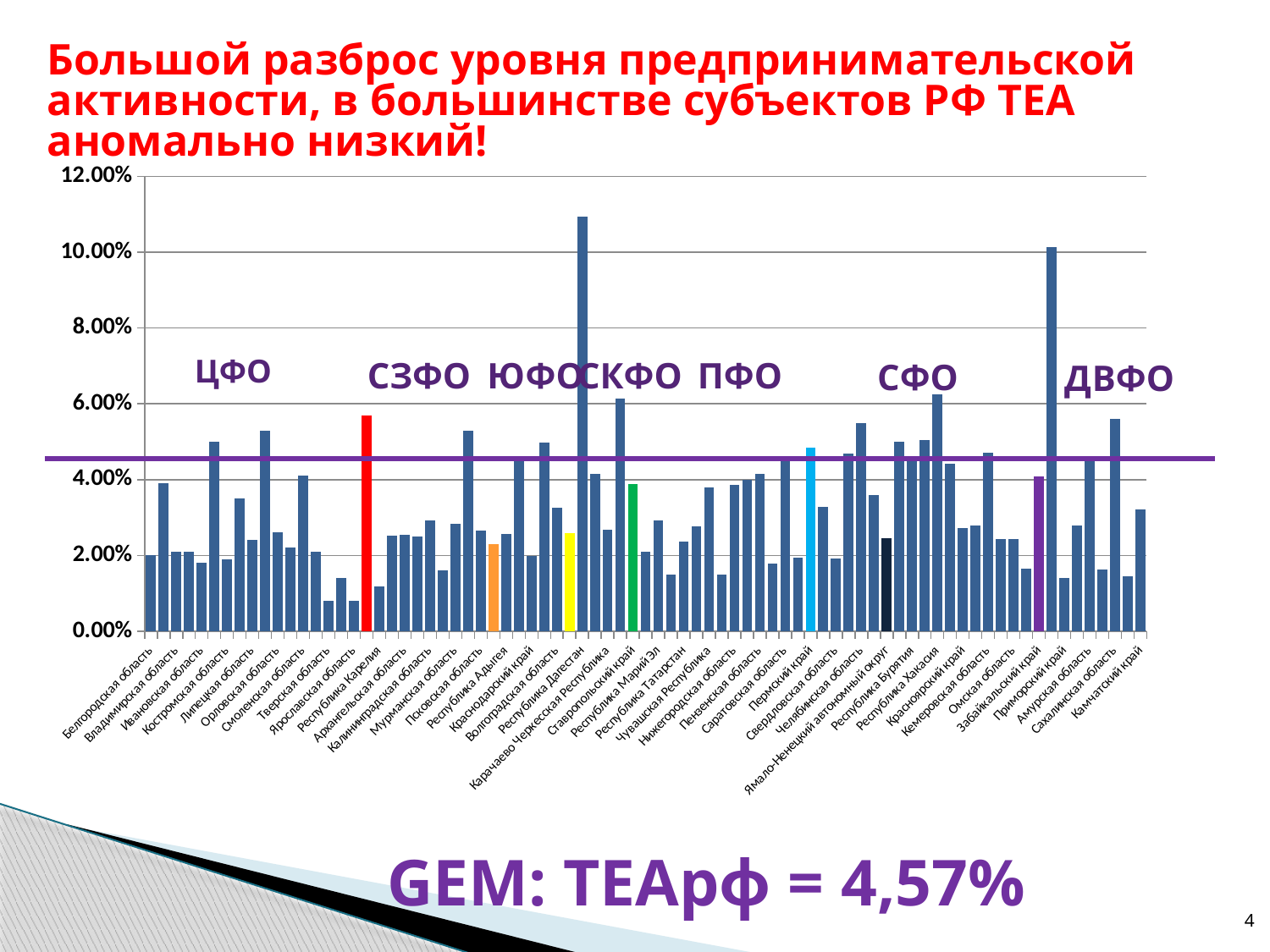
Is the value of the red bar greater or less than 6.00%? less How many federal district labels (such as ЦФО, СЗФО) are printed across the chart area? 7 Is the value of the black bar greater or less than 4.00%? less Is the value of the red bar greater or less than 4.00%? greater What is the highest tick value shown on the y axis? 12.00% What kind of chart is shown on the slide? bar chart What TEA value for the Russian Federation is stated in the text below the chart? 4,57%